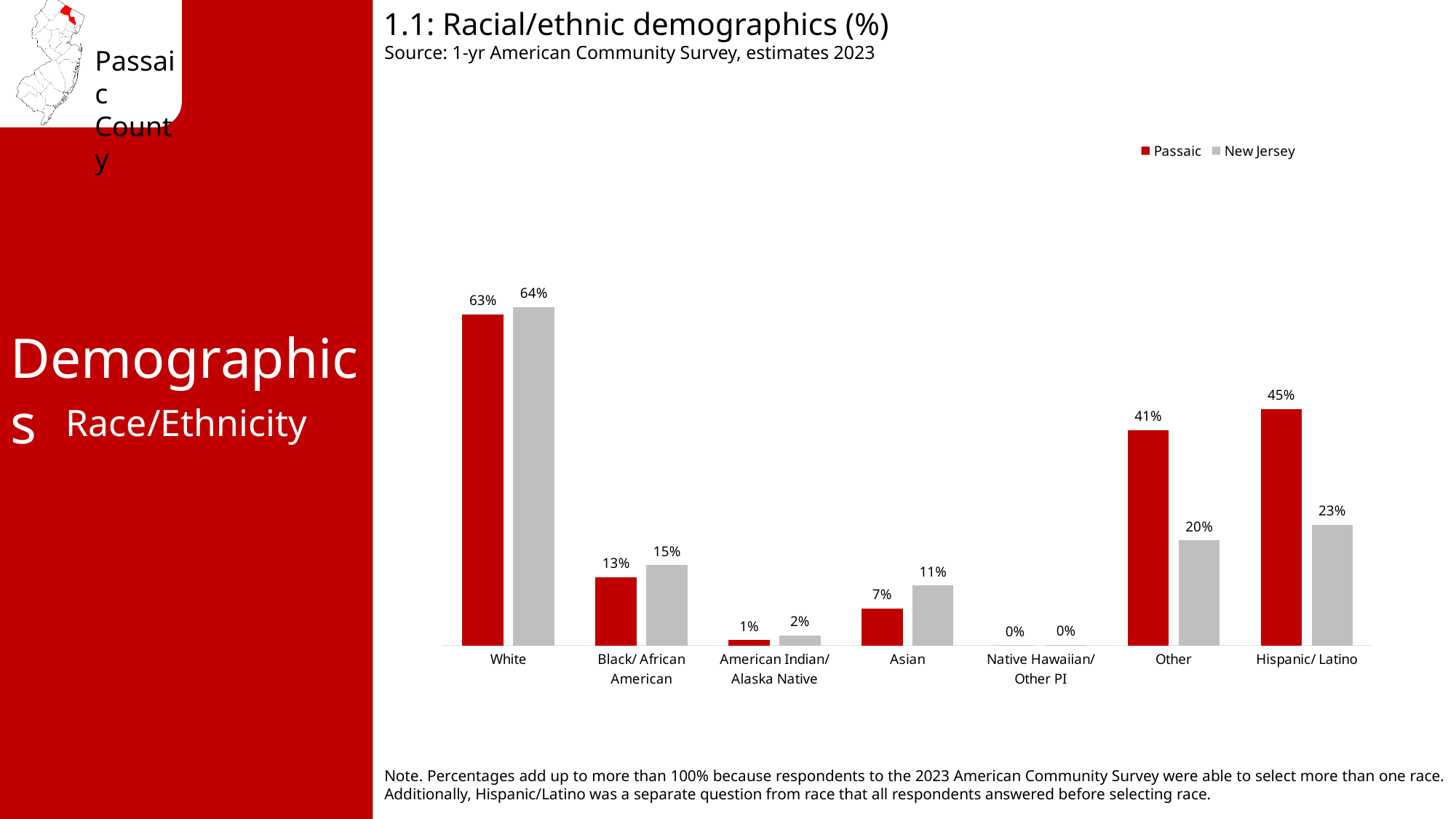
Which category has the highest Passaic value? White Which is larger for Asian, the Passaic value or the New Jersey value? New Jersey How many categories are shown on the x axis? 7 What is the difference between the Passaic and New Jersey values for Hispanic/ Latino? 22% Which category has the lowest New Jersey value? Native Hawaiian/ Other PI What is the New Jersey value for Asian? 11% What is the Passaic value for White? 63% What kind of chart is shown on the slide? Bar chart What is the difference between the Passaic and New Jersey values for Other? 21% What is the New Jersey value for Hispanic/ Latino? 23% What is the Passaic value for Other? 41% How many series does the legend list? 2